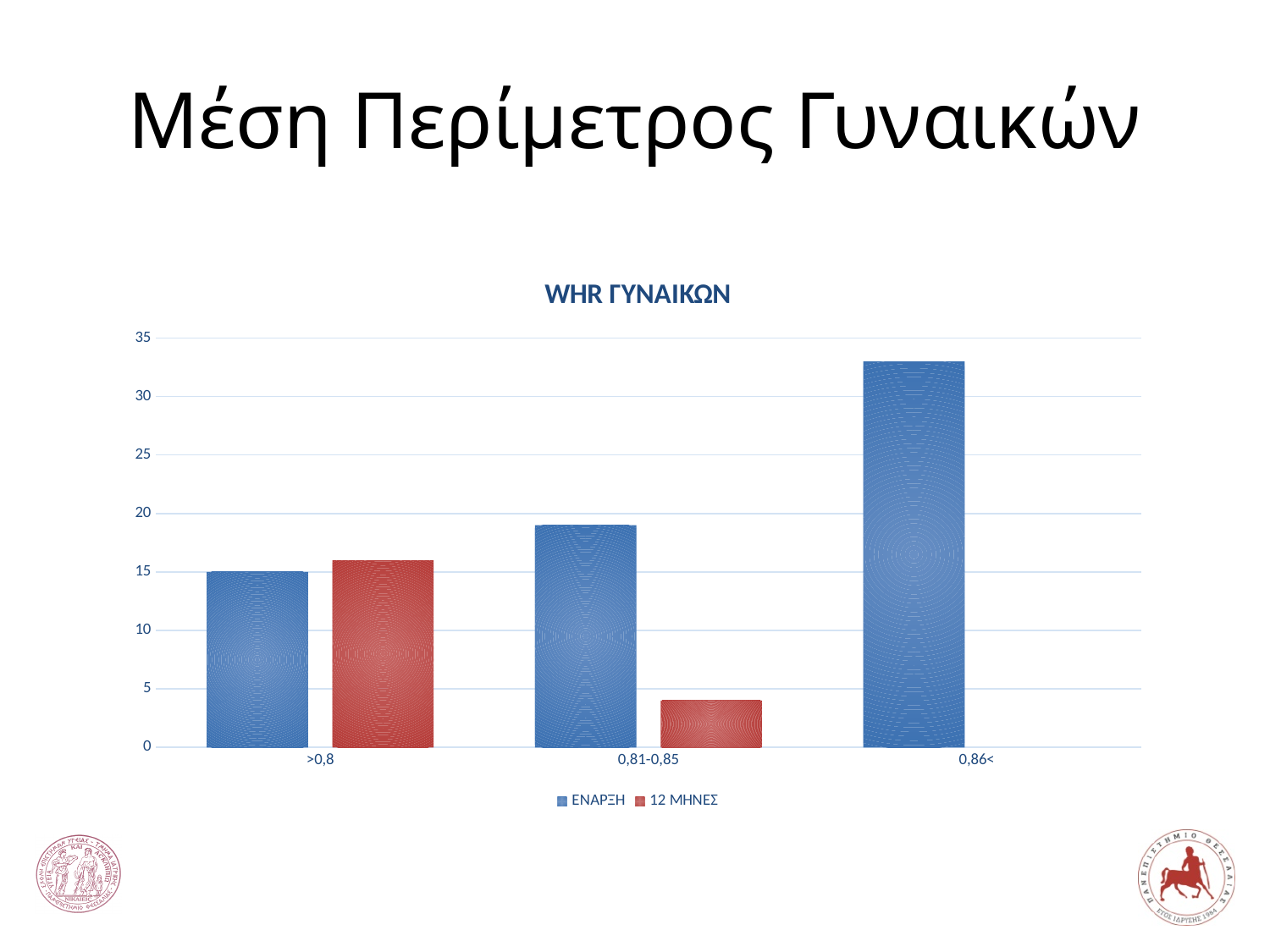
Is the 12 ΜΗΝΕΣ value for >0,8 greater or less than 10? greater Which category has the lowest ΕΝΑΡΞΗ value? >0,8 Is the ΕΝΑΡΞΗ value for 0,81-0,85 greater or less than 15? greater Do the ΕΝΑΡΞΗ values rise or fall from >0,8 to 0,86< along the x axis? rise Is the ΕΝΑΡΞΗ value for 0,86< greater or less than 30? greater What is the title of the chart? WHR ΓΥΝΑΙΚΩΝ Which category has the highest ΕΝΑΡΞΗ value? 0,86< What kind of chart is shown on the slide? bar chart How many series does the legend of the WHR ΓΥΝΑΙΚΩΝ chart list? 2 How many categories are shown on the x axis of the chart? 3 For the category 0,81-0,85, which series has the larger value, ΕΝΑΡΞΗ or 12 ΜΗΝΕΣ? ΕΝΑΡΞΗ